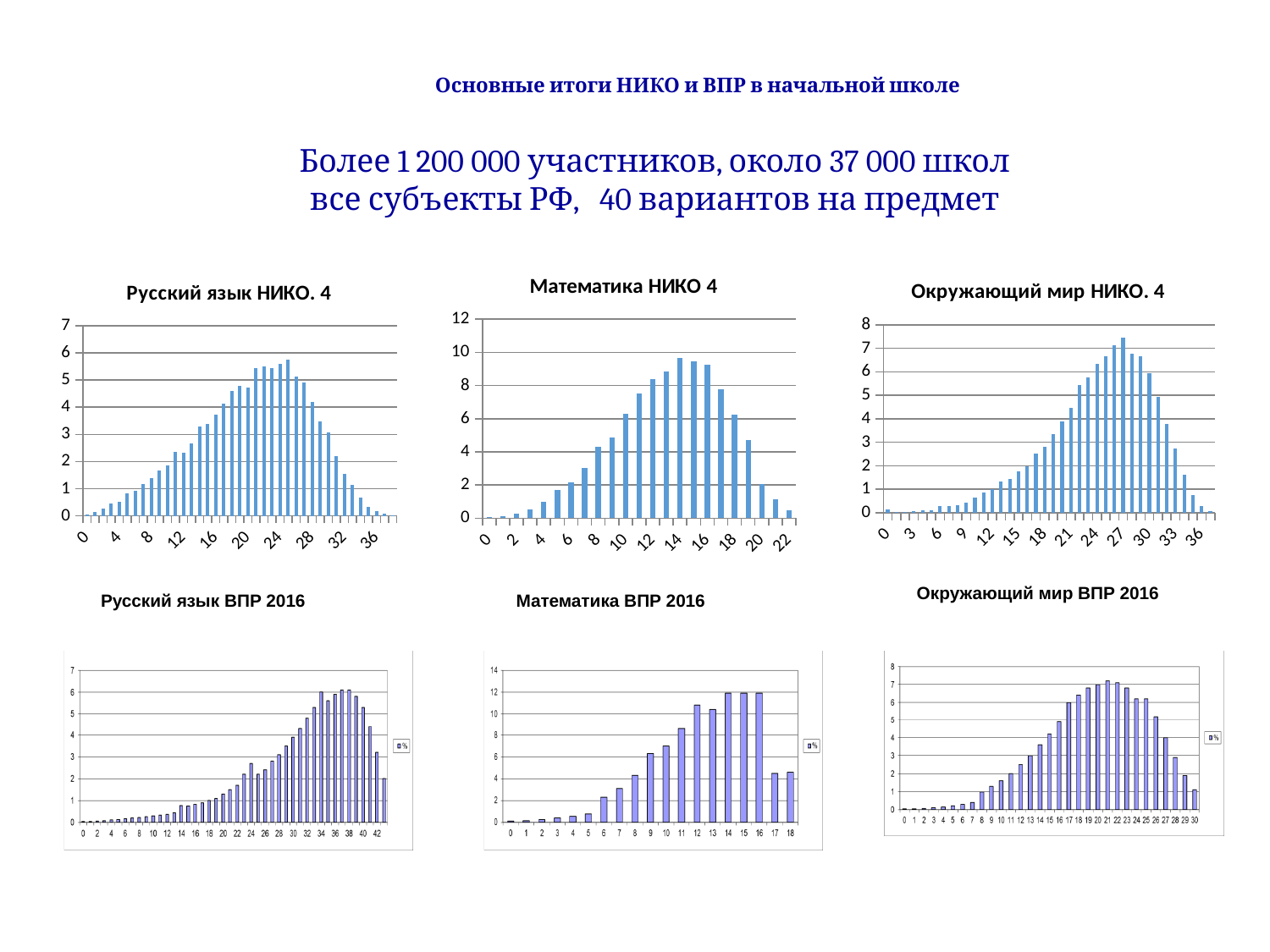
In the "Математика НИКО 4" chart, is the value for 14 greater or less than 8? greater How many series does the legend of the "Окружающий мир ВПР 2016" chart list? 1 In the "Окружающий мир НИКО. 4" chart, which category has the highest value? 27 In the "Русский язык НИКО. 4" chart, is the value for 20 greater or less than 4? greater In the "Математика НИКО 4" chart, do the values rise or fall along the x axis from 0 to 14? rise In the "Математика НИКО 4" chart, is the value for 20 greater or less than 4? less How many charts are shown on the slide? 6 What kind of chart is "Математика НИКО 4"? bar chart